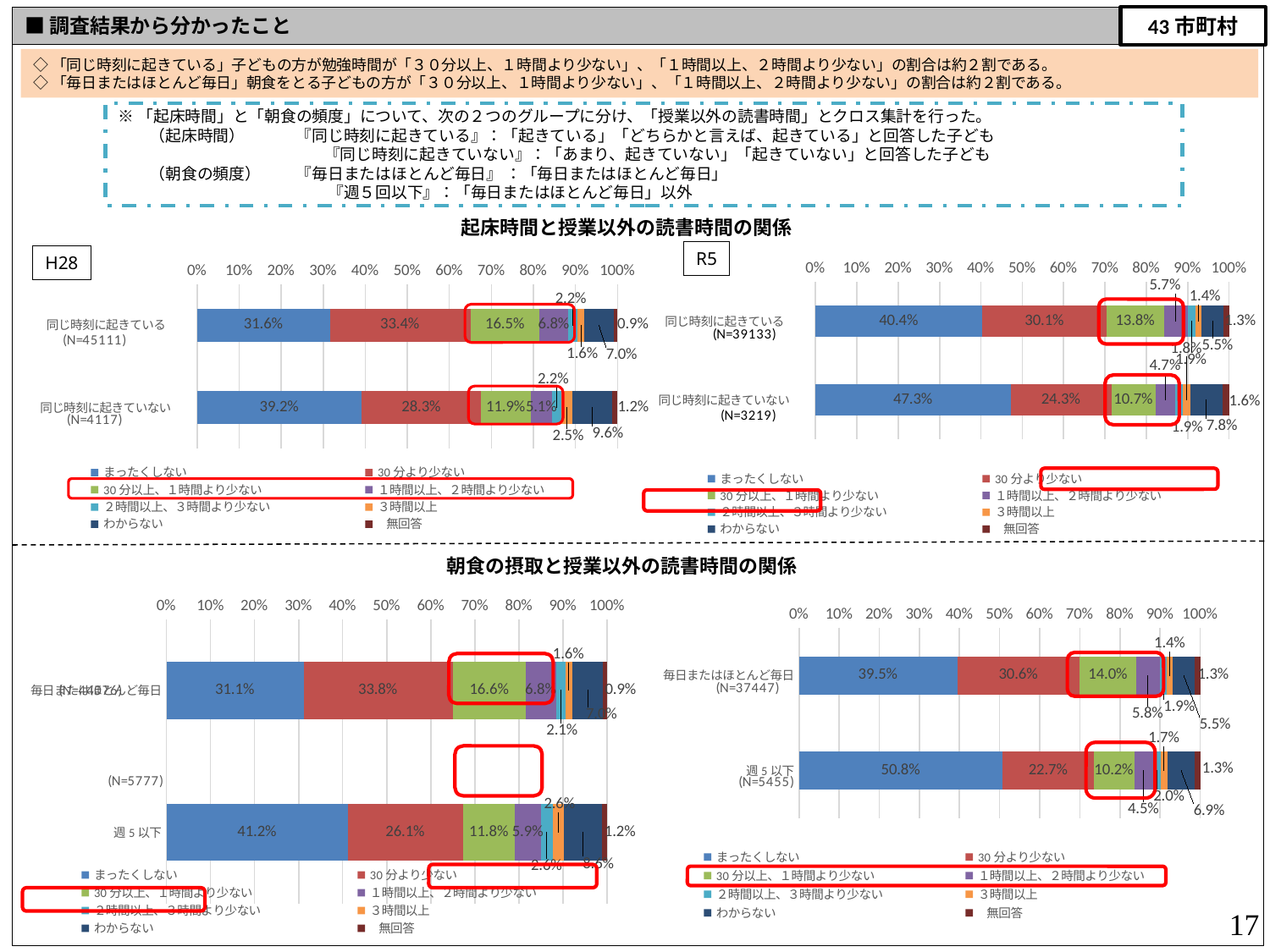
What kind of chart is the top-right chart (R5, 起床時間と授業以外の読書時間の関係)? Stacked bar chart In the top-right chart (R5, 起床時間と授業以外の読書時間の関係), what is the N for 同じ時刻に起きている? N=39133 How many series does the legend of the top-left chart (H28, 起床時間と授業以外の読書時間の関係) list? 8 In the top-left chart (H28, 起床時間と授業以外の読書時間の関係), what is the difference between the まったくしない values for 同じ時刻に起きていない and 同じ時刻に起きている? 7.6% In the top-left chart (H28, 起床時間と授業以外の読書時間の関係), what is the value of まったくしない for 同じ時刻に起きている? 31.6% In the bottom-right chart (R5, 朝食の摂取と授業以外の読書時間の関係), which category has the larger 30分より少ない value, 毎日またはほとんど毎日 or 週5以下? 毎日またはほとんど毎日 In the top-right chart (R5, 起床時間と授業以外の読書時間の関係), what is the value of まったくしない for 同じ時刻に起きていない? 47.3% In the top-right chart (R5, 起床時間と授業以外の読書時間の関係), what is the difference between the 30分以上、1時間より少ない values for 同じ時刻に起きている and 同じ時刻に起きていない? 3.1% In the bottom-left chart (H28, 朝食の摂取と授業以外の読書時間の関係), what is the value of まったくしない for 週5以下? 41.2% In the bottom-right chart (R5, 朝食の摂取と授業以外の読書時間の関係), what is the value of まったくしない for 週5以下? 50.8% In the bottom-left chart (H28, 朝食の摂取と授業以外の読書時間の関係), what is the value of 30分以上、1時間より少ない for 毎日またはほとんど毎日? 16.6% In the top-left chart (H28, 起床時間と授業以外の読書時間の関係), what is the value of 30分以上、1時間より少ない for 同じ時刻に起きていない? 11.9%